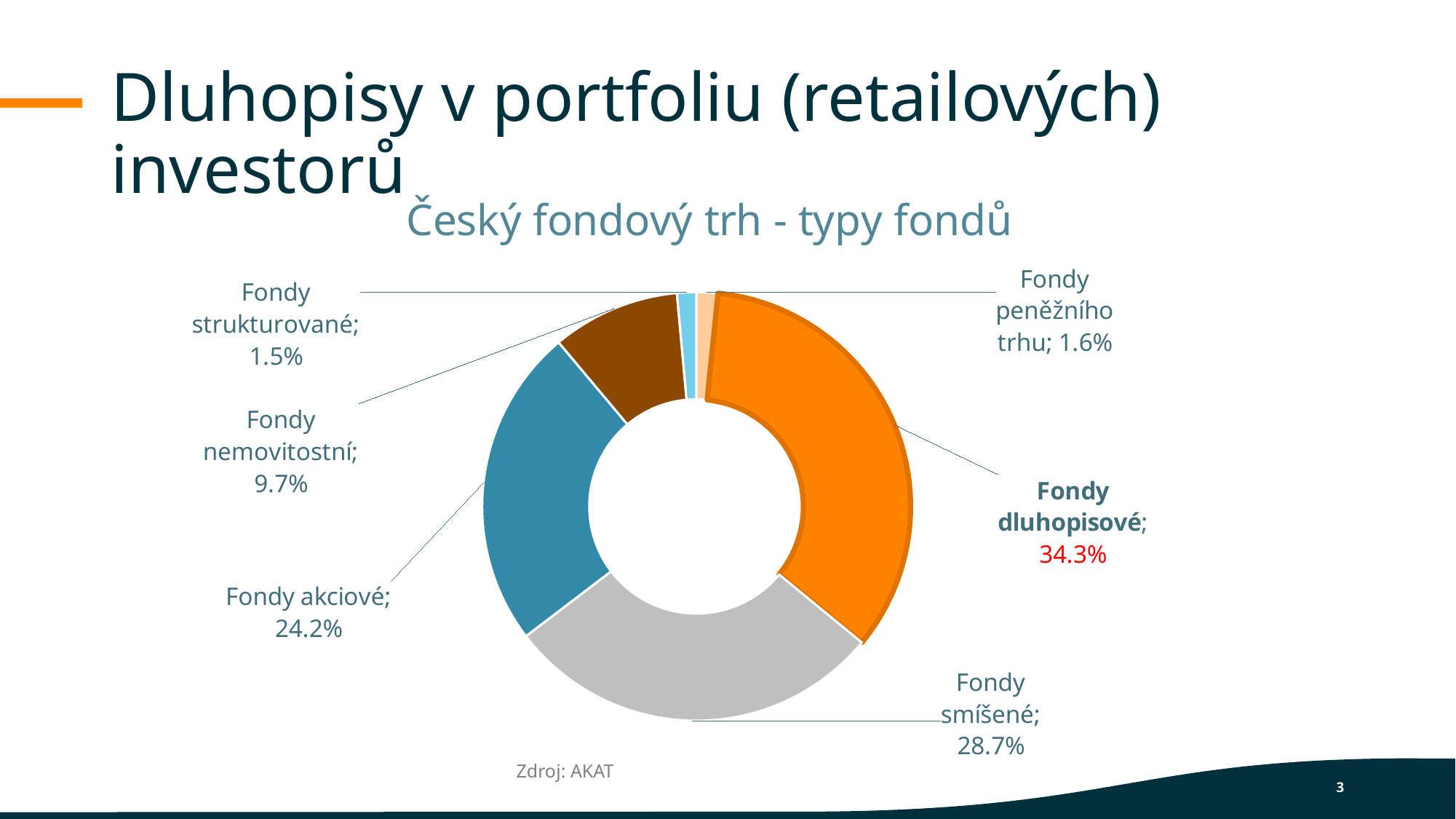
Which fund type has the smallest share in the chart? Fondy strukturované Which fund type has the largest share in the chart? Fondy dluhopisové What is the share of Fondy peněžního trhu? 1.6% What is the share of Fondy dluhopisové in the chart? 34.3% What is the title of the chart? Český fondový trh - typy fondů What is the share of Fondy smíšené? 28.7% How many fund types are shown in the chart? 6 What is the difference in percentage points between Fondy dluhopisové and Fondy smíšené? 5.6 Which has a larger share, Fondy akciové or Fondy smíšené? Fondy smíšené What is the difference in percentage points between Fondy akciové and Fondy nemovitostní? 14.5 What is the share of Fondy nemovitostní? 9.7% What kind of chart is shown on the slide? Doughnut (pie) chart